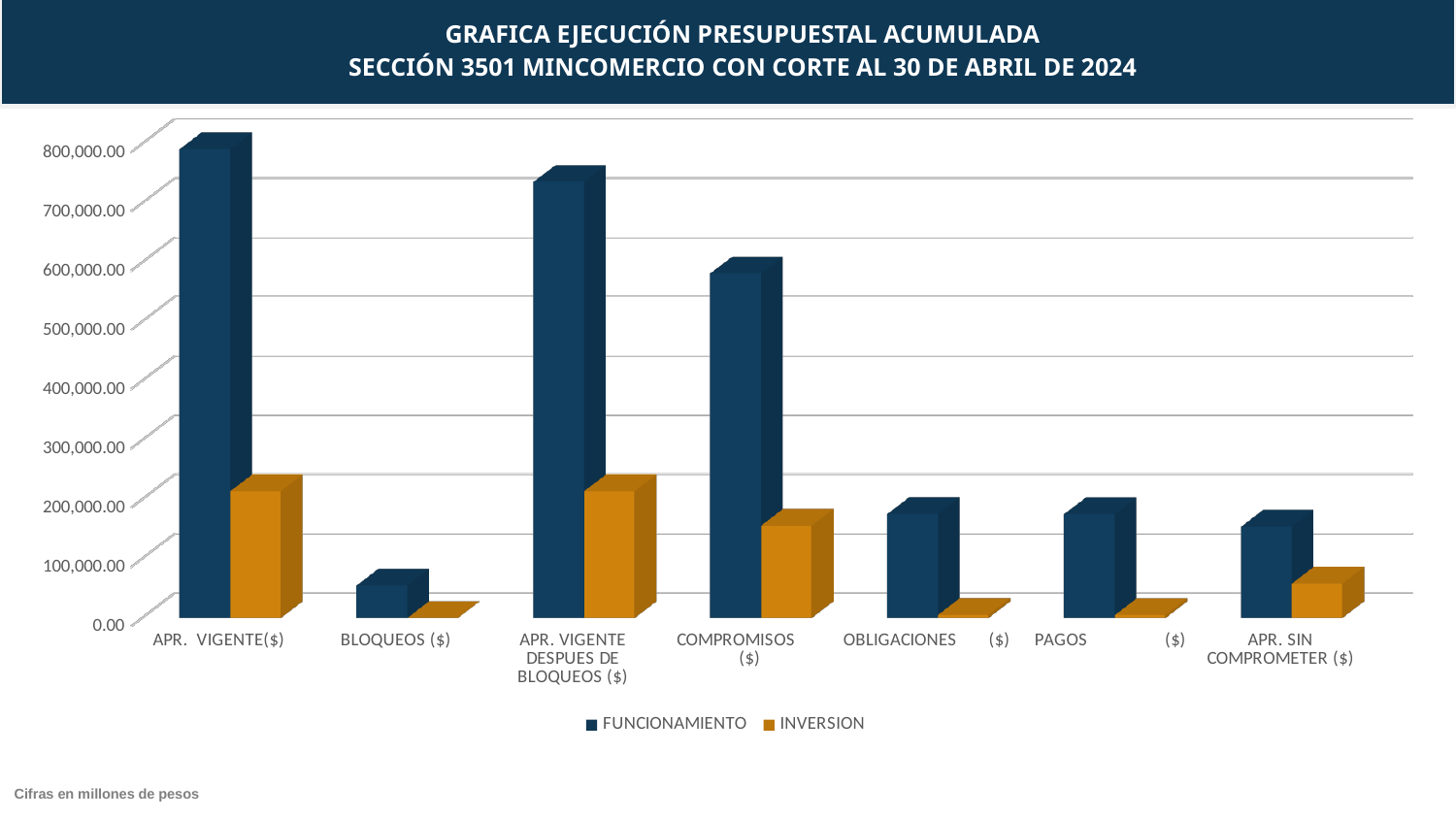
Which category has the lowest FUNCIONAMIENTO value? BLOQUEOS ($) According to the note at the bottom of the slide, in what units are the figures expressed? millones de pesos How many series does the legend list? 2 Is the INVERSION value for APR. VIGENTE($) greater or less than 300,000.00? less Which category has the highest FUNCIONAMIENTO value? APR. VIGENTE($) Is the FUNCIONAMIENTO value for APR. VIGENTE($) greater or less than 700,000.00? greater How many categories are shown along the x axis? 7 What kind of chart is shown on the slide? bar chart Is the FUNCIONAMIENTO value for BLOQUEOS ($) greater or less than 100,000.00? less For COMPROMISOS ($), which series has the larger value, FUNCIONAMIENTO or INVERSION? FUNCIONAMIENTO Which series is shown in orange in the legend? INVERSION